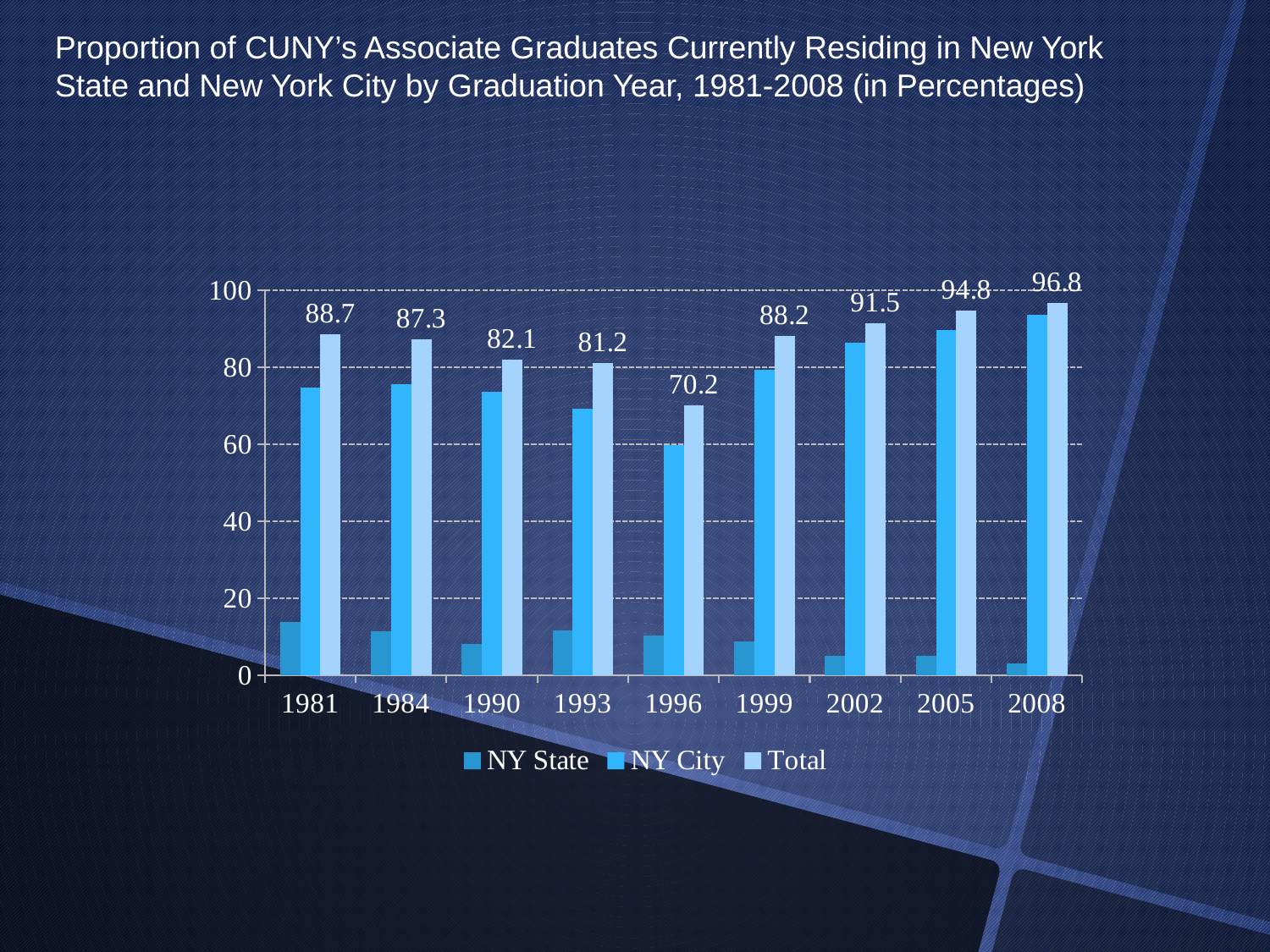
How many graduation years are shown on the x axis? 9 What kind of chart is shown on the slide? Bar chart Which graduation year has the highest Total value? 2008 Which is larger, the Total value for 1981 or the Total value for 1999? 1981 Is the NY State value for 2008 greater or less than 20? less Which graduation year has the lowest Total value? 1996 What is the Total value for 1984? 87.3 Is the NY City value for 1996 greater or less than 80? less How many series does the legend list? 3 What is the difference between the Total values for 2008 and 1996? 26.6 What is the Total value for 1996? 70.2 What is the Total value for 2008? 96.8